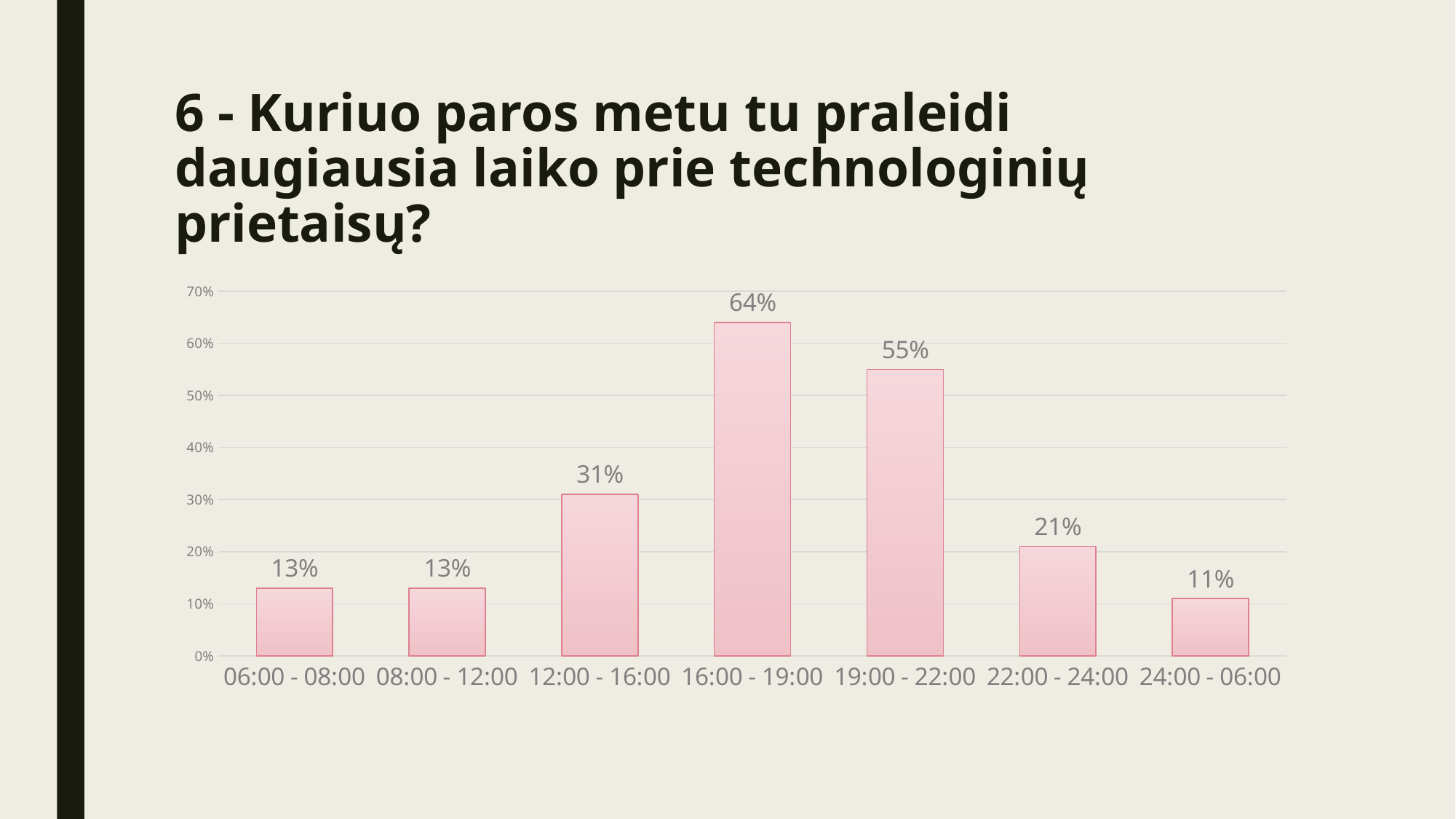
Which time slot has the lowest value? 24:00 - 06:00 What is the difference between the values for 16:00 - 19:00 and 19:00 - 22:00? 9% What is the difference between the values for 12:00 - 16:00 and 22:00 - 24:00? 10% How many time slots are shown on the x axis? 7 What is the value for the 16:00 - 19:00 time slot? 64% Is the value for 19:00 - 22:00 greater or less than 50%? greater What is the value for the 22:00 - 24:00 time slot? 21% Which two time slots share the same value of 13%? 06:00 - 08:00 and 08:00 - 12:00 Which is larger, the value for 19:00 - 22:00 or the value for 12:00 - 16:00? 19:00 - 22:00 Which time slot has the highest value? 16:00 - 19:00 What kind of chart is shown on the slide? bar chart What is the value for the 12:00 - 16:00 time slot? 31%